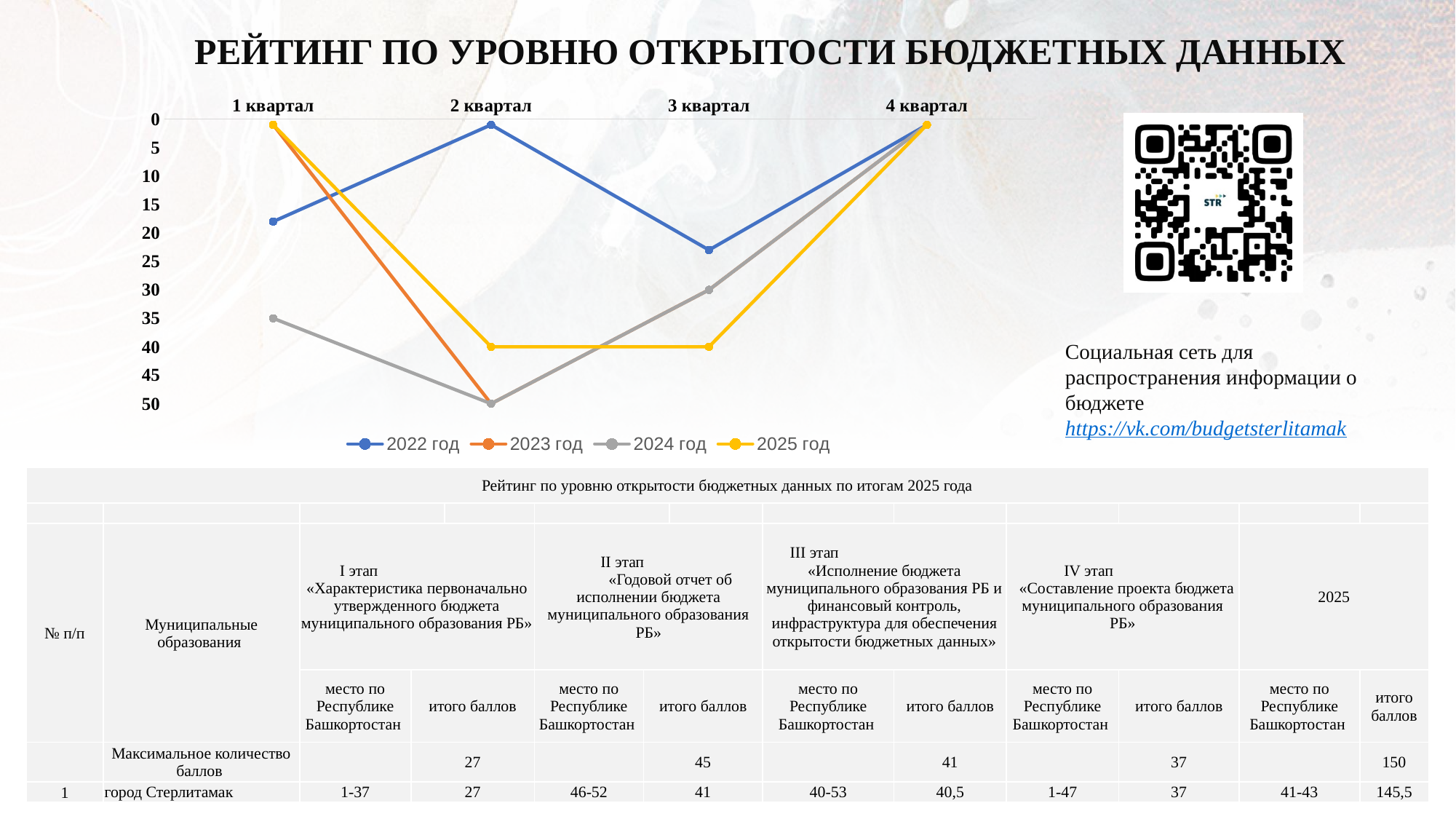
Which series are listed in the chart legend? 2022 год, 2023 год, 2024 год, 2025 год How many series does the chart legend list? 4 Is the value for 2023 год in 2 квартал greater or less than 45? greater What is the value for 2025 год in 2 квартал? 40 What kind of chart is shown on the slide? line chart Does the value for 2024 год rise or fall from 2 квартал to 4 квартал? fall In 1 квартал, which series has the highest value? 2024 год What is the value for 2024 год in 3 квартал? 30 What is the title of the slide above the chart? РЕЙТИНГ ПО УРОВНЮ ОТКРЫТОСТИ БЮДЖЕТНЫХ ДАННЫХ Is the value for 2022 год in 1 квартал greater or less than 20? less What is the value for 2024 год in 1 квартал? 35 How many quarters (categories) are plotted along the x axis of the chart? 4